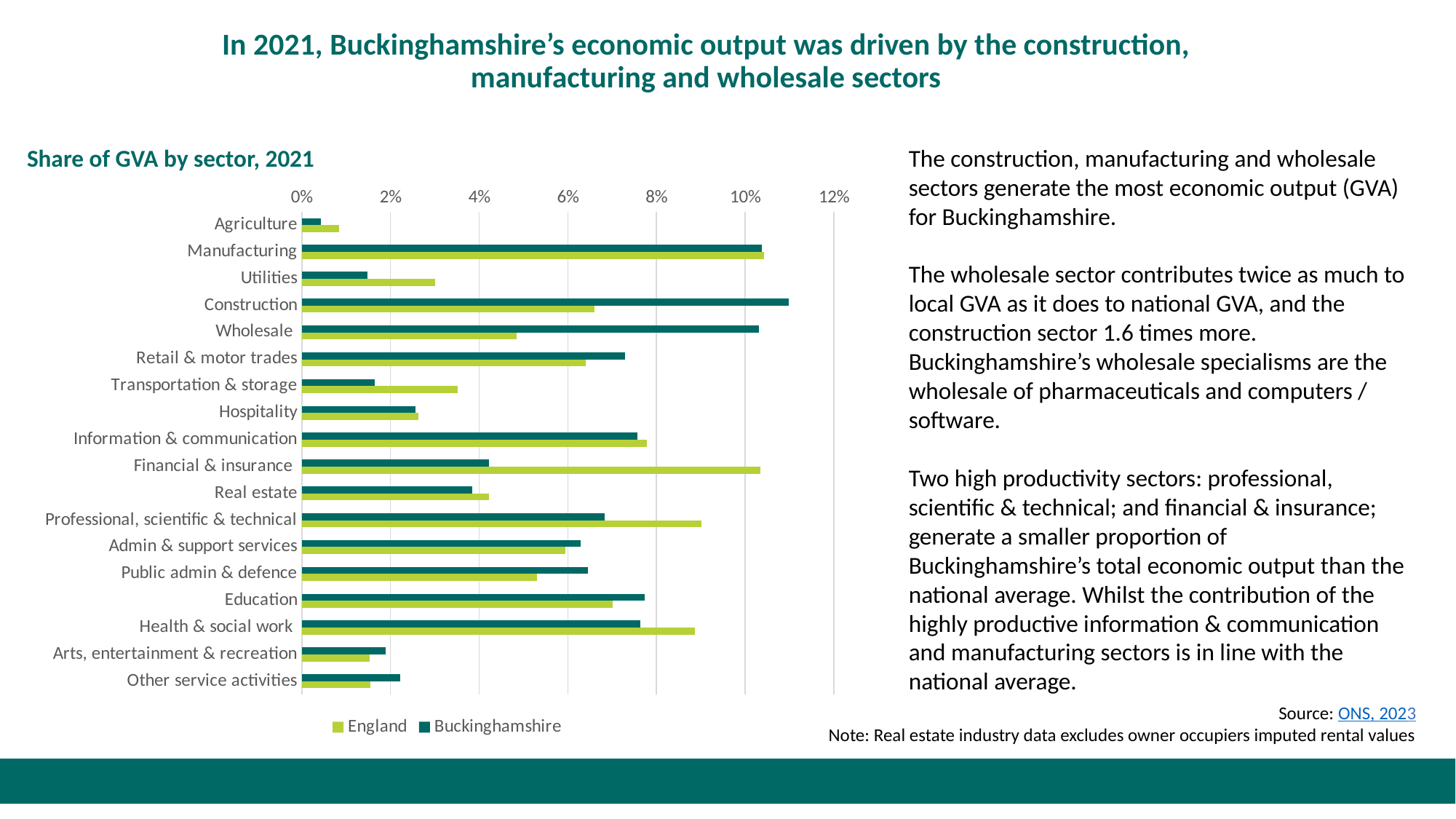
For Wholesale, which is larger: the England value or the Buckinghamshire value? Buckinghamshire Is the England value for Wholesale greater or less than 6%? less Is the Buckinghamshire value for Financial & insurance greater or less than 6%? less Which sector has the highest share of GVA for Buckinghamshire? Construction Is the Buckinghamshire value for Construction greater or less than 10%? greater How many sectors are shown on the chart? 18 How many series does the legend list? 2 What is the title of the chart? Share of GVA by sector, 2021 For Financial & insurance, which is larger: the England value or the Buckinghamshire value? England Which sector has the lowest share of GVA for England? Agriculture What kind of chart is shown on the slide? Bar chart Which sector has the lowest share of GVA for Buckinghamshire? Agriculture